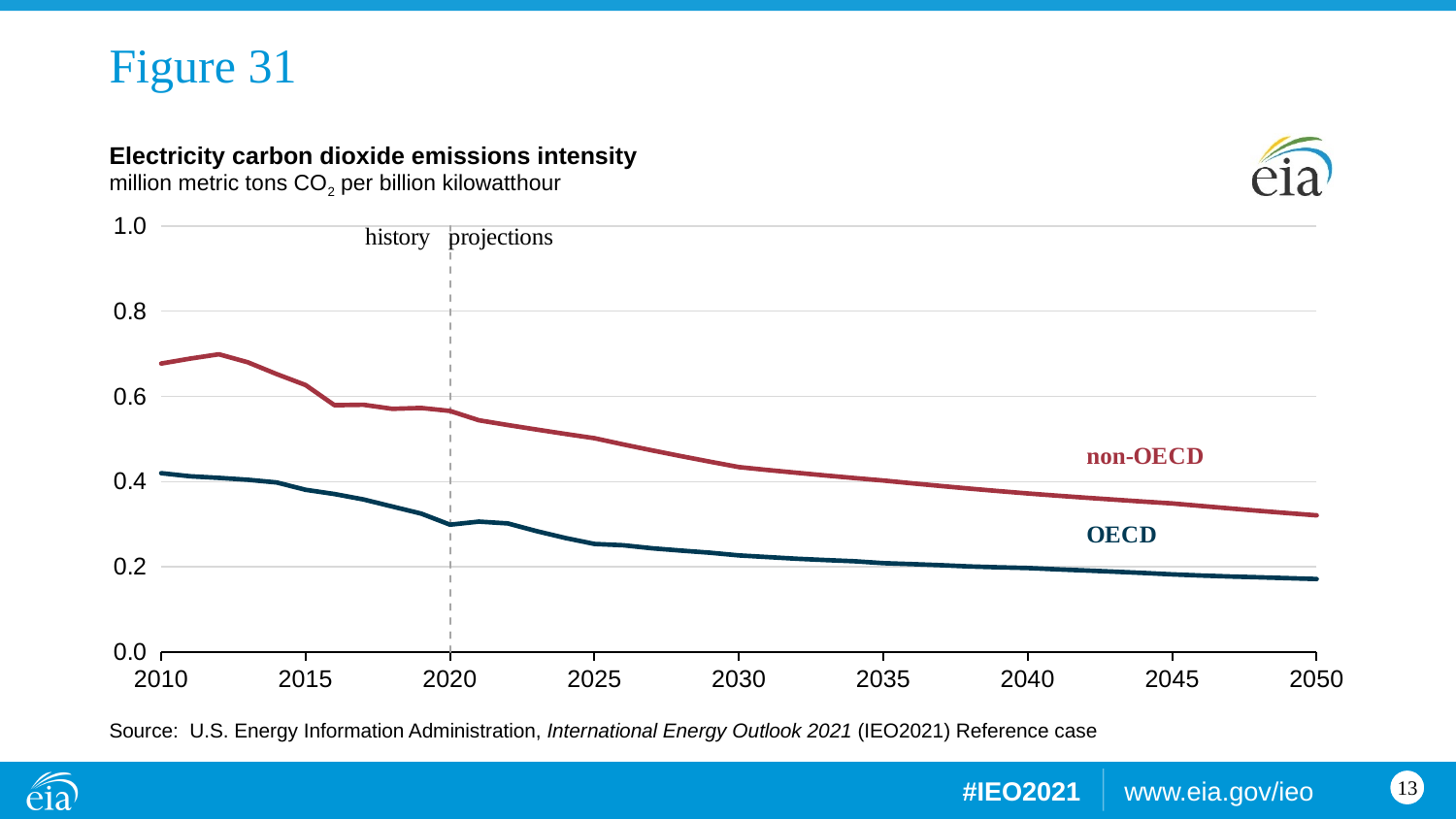
Is the non-OECD value in 2050 greater or less than 0.4? less What is the title of the chart? Electricity carbon dioxide emissions intensity Does the OECD emissions intensity rise or fall between 2010 and 2050? fall Does the non-OECD emissions intensity rise or fall between 2020 and 2050? fall Is the OECD value in 2020 greater or less than 0.4? less What kind of chart is shown on the slide? line chart Which series has the lower electricity carbon dioxide emissions intensity in 2010? OECD What are the names of the two series plotted on the chart? non-OECD and OECD Is the non-OECD value in 2010 greater or less than 0.6? greater How many series are plotted on the chart? 2 Which series has the higher electricity carbon dioxide emissions intensity in 2050? non-OECD